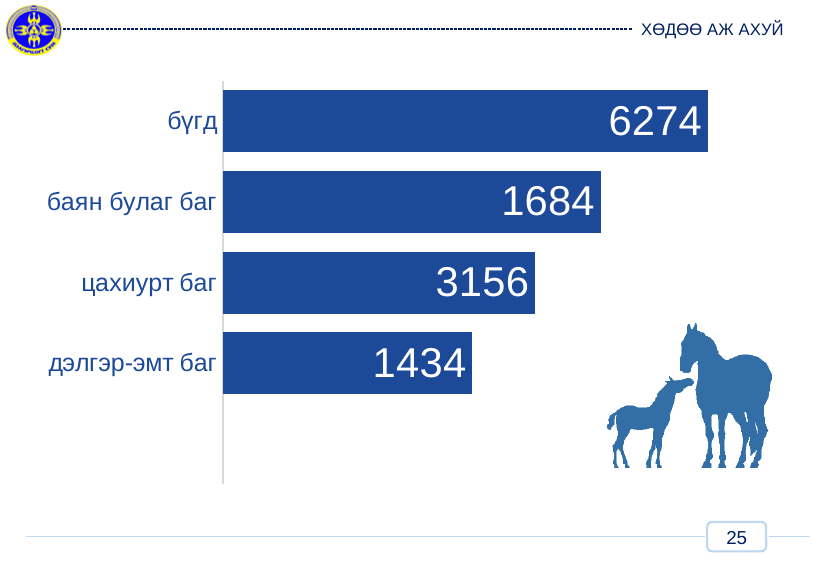
Which category has the highest value? бүгд What is the value for цахиурт баг? 3156 Which has a larger value, цахиурт баг or дэлгэр-эмт баг? цахиурт баг What kind of chart is shown on the slide? bar chart What is the value for бүгд? 6274 What is the value for дэлгэр-эмт баг? 1434 What is the difference between the values for цахиурт баг and баян булаг баг? 1472 What is the value for баян булаг баг? 1684 How many categories are shown in the chart? 4 What is the difference between the values for баян булаг баг and дэлгэр-эмт баг? 250 What is the heading text in the top right corner of the slide? ХӨДӨӨ АЖ АХУЙ Which category has the lowest value? дэлгэр-эмт баг